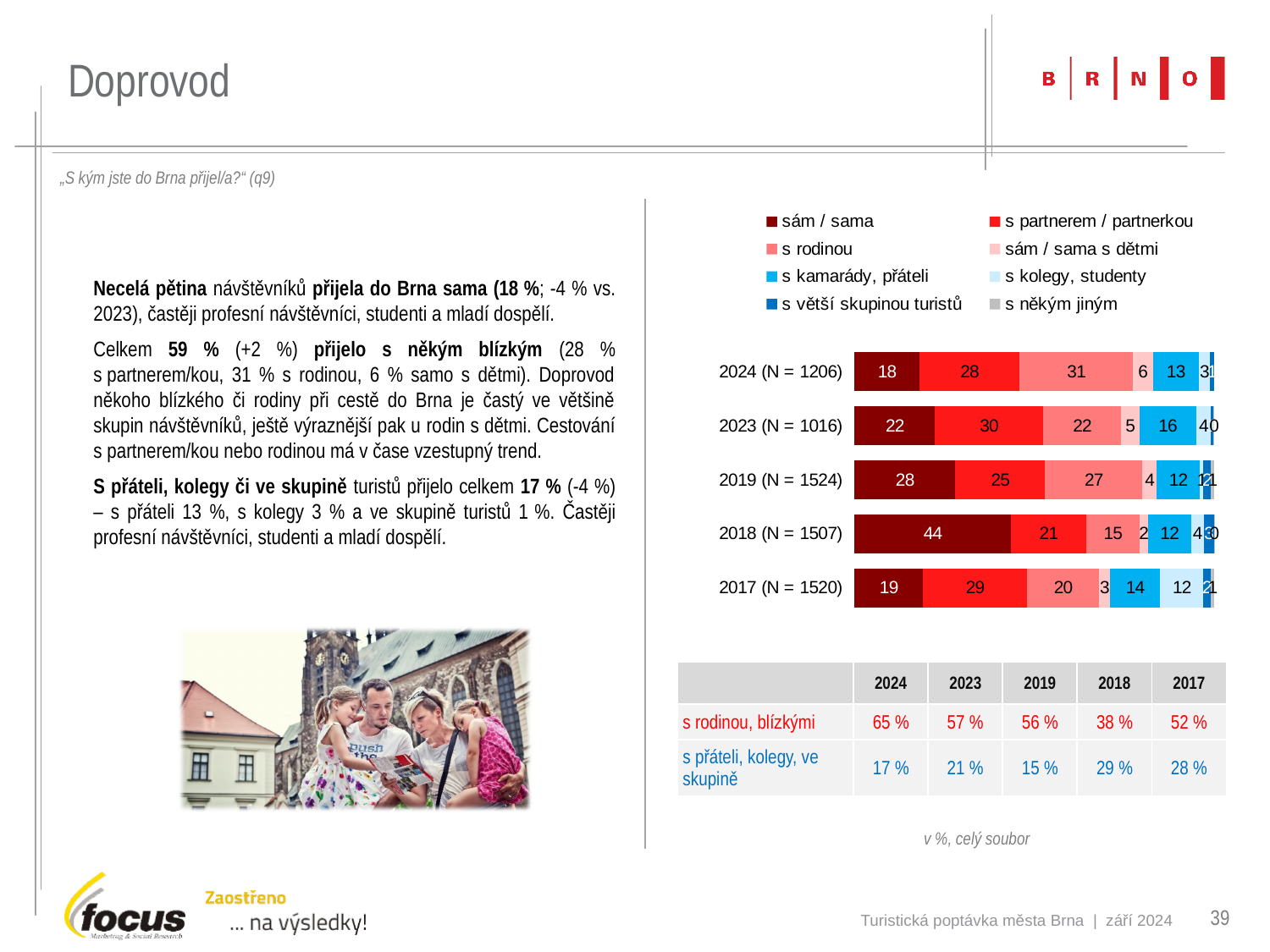
What is the difference between the "s rodinou" value in 2024 and in 2023? 9 Which legend entry is shown in the darkest red colour? sám / sama What kind of chart is shown on the slide? stacked bar chart What is the value for "s kamarády, přáteli" in the 2017 (N = 1520) bar? 14 In which year is the "sám / sama" segment the largest? 2018 (N = 1507) Which year has the larger "s partnerem / partnerkou" value, 2024 or 2023? 2023 What is the value for "s rodinou" in the 2019 (N = 1524) bar? 27 Does the "sám / sama" value rise or fall from 2018 through 2019, 2023 to 2024? fall How many series does the chart legend list? 8 What is the value for "s partnerem / partnerkou" in the 2023 (N = 1016) bar? 30 How many bars (years) are plotted in the chart? 5 What is the value for "sám / sama" in the 2024 (N = 1206) bar? 18